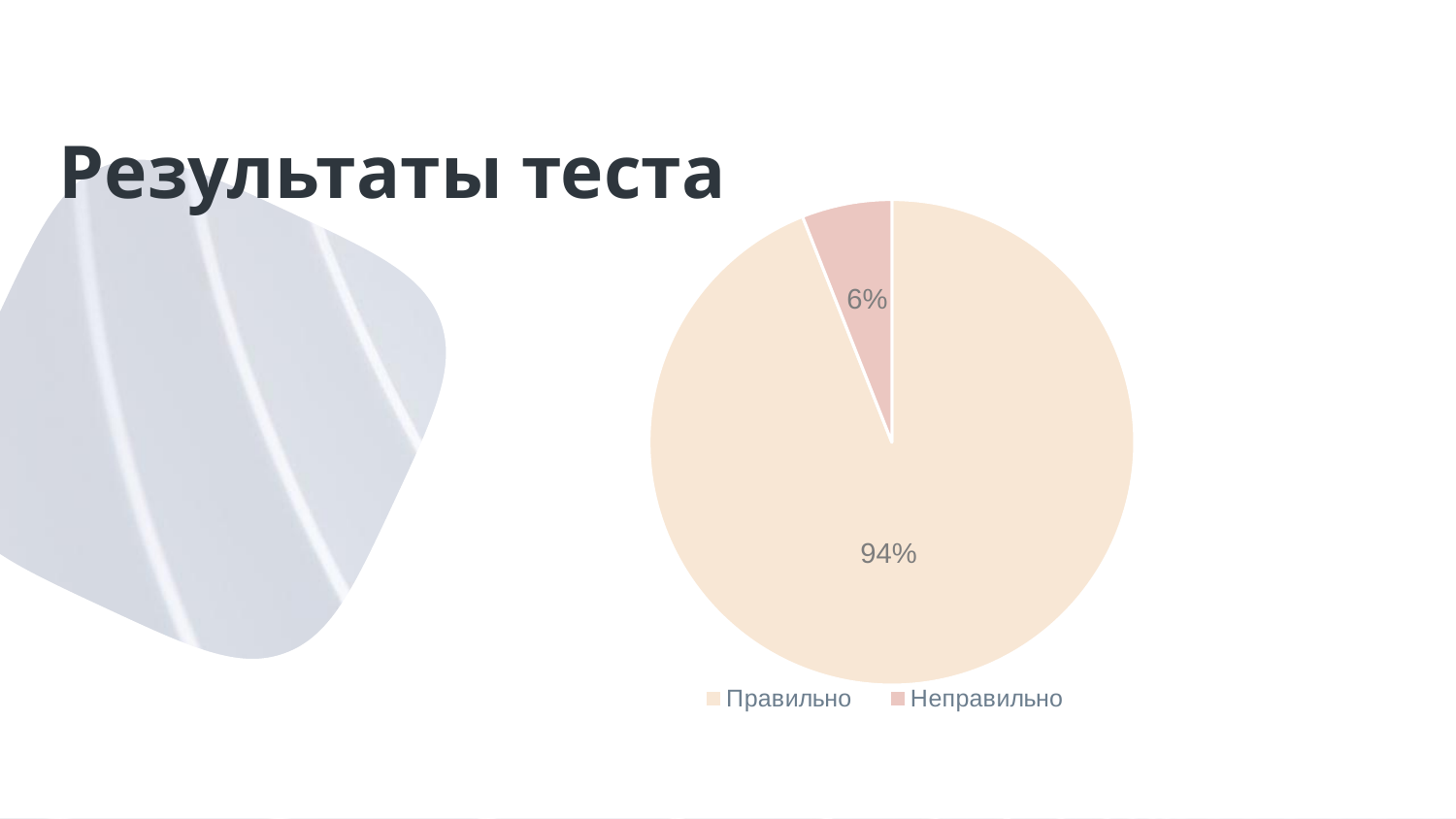
Which legend entry is shown in pink? Неправильно What is the title of the slide? Результаты теста What is the difference in percentage points between Правильно and Неправильно? 88 What share of the pie does Правильно take? 94% What kind of chart is shown on the slide? Pie chart Which slice is the smallest? Неправильно What share of the pie does Неправильно take? 6% How many entries does the legend list? 2 Which slice is the largest? Правильно Which is larger, Правильно or Неправильно? Правильно How many slices does the pie chart have? 2